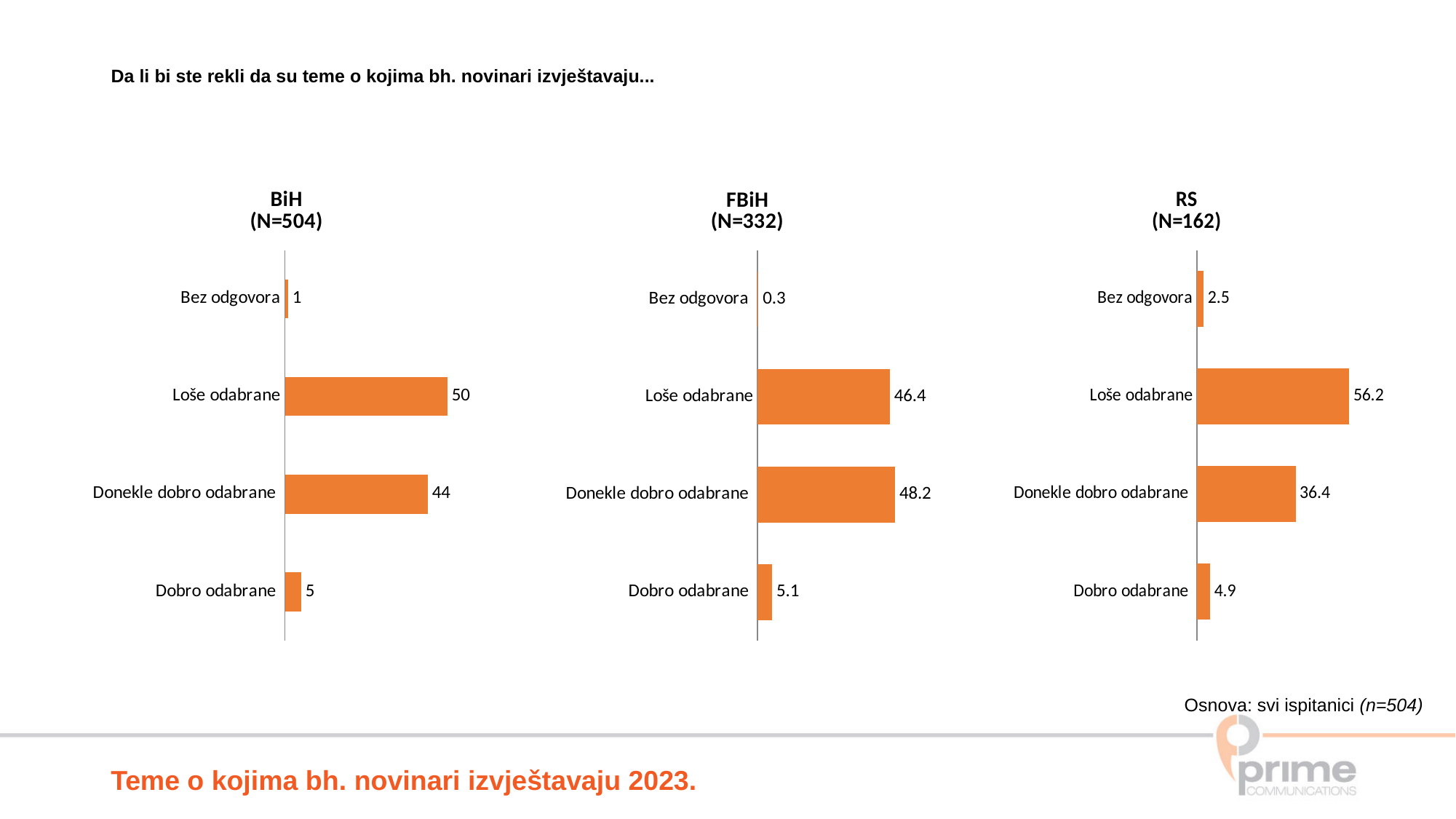
How many categories does the RS (N=162) chart show? 4 In the FBiH (N=332) chart, what is the value for Donekle dobro odabrane? 48.2 In the RS (N=162) chart, which category has the highest value? Loše odabrane In the RS (N=162) chart, what is the difference between Loše odabrane and Donekle dobro odabrane? 19.8 How many charts are shown on the slide? 3 In the BiH (N=504) chart, what is the value for Loše odabrane? 50 In the FBiH (N=332) chart, which is larger: Loše odabrane or Donekle dobro odabrane? Donekle dobro odabrane In the BiH (N=504) chart, which is larger: Dobro odabrane or Bez odgovora? Dobro odabrane In the RS (N=162) chart, what is the value for Bez odgovora? 2.5 In the FBiH (N=332) chart, which category has the lowest value? Bez odgovora In the BiH (N=504) chart, what is the difference between Loše odabrane and Donekle dobro odabrane? 6 What type of chart is the FBiH (N=332) chart? Bar chart